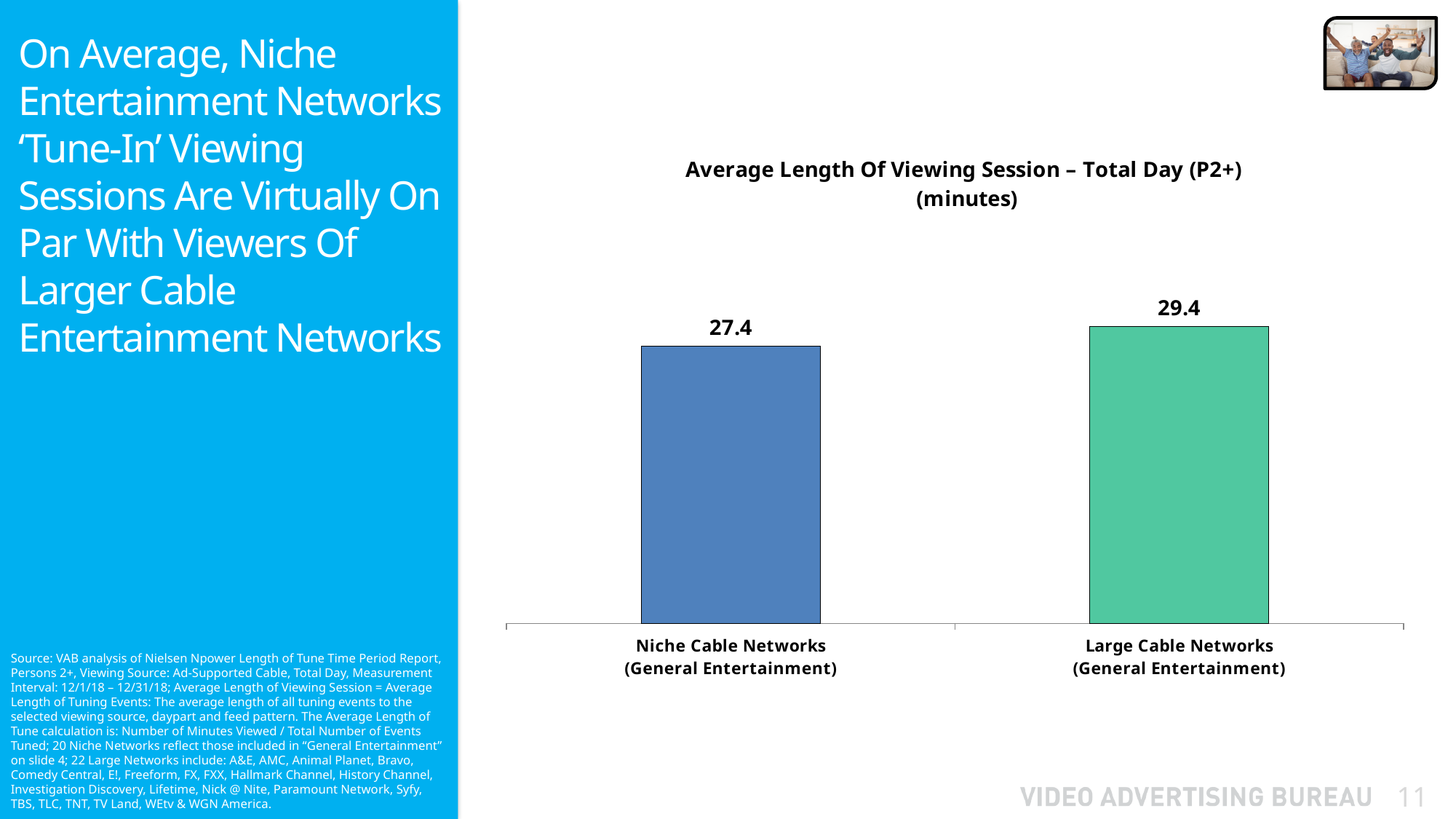
Is the value for Niche Cable Networks larger or smaller than the value for Large Cable Networks? smaller In what unit are the chart values expressed? minutes What is the title of the chart? Average Length Of Viewing Session – Total Day (P2+) (minutes) What kind of chart is shown on the slide? bar chart What is the difference in minutes between the Large Cable Networks and Niche Cable Networks viewing session lengths? 2.0 What colour is the bar for Large Cable Networks (General Entertainment)? green Which category has the higher average length of viewing session? Large Cable Networks (General Entertainment) How many categories are shown in the chart? 2 What is the average length of viewing session for Large Cable Networks (General Entertainment)? 29.4 What is the average length of viewing session for Niche Cable Networks (General Entertainment)? 27.4 Which category has the lower average length of viewing session? Niche Cable Networks (General Entertainment)